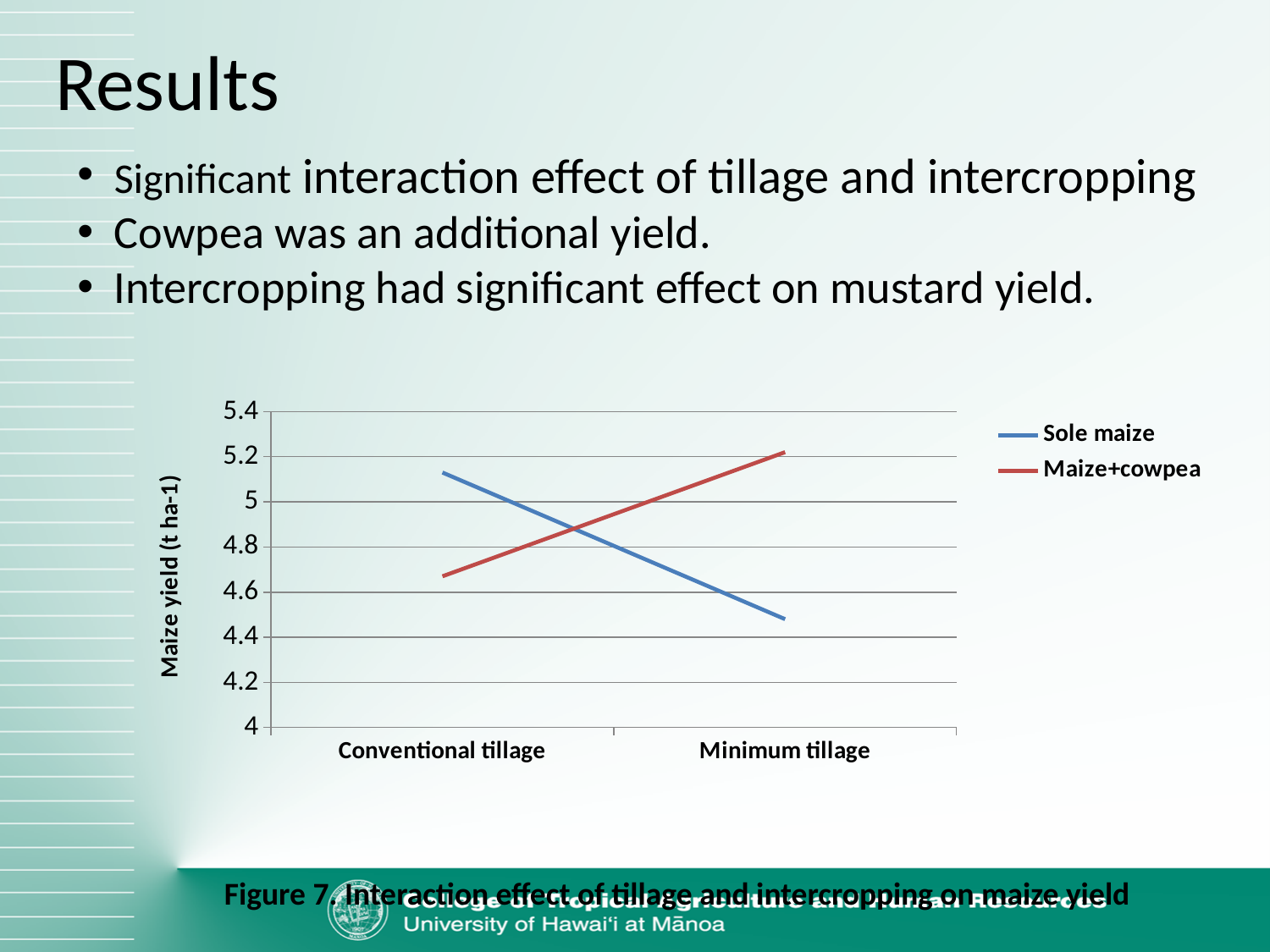
Is the value for Maize+cowpea under Minimum tillage greater or less than 5? greater Does the Sole maize line rise or fall from Conventional tillage to Minimum tillage? fall What kind of chart is shown on the slide? Line chart How many series does the legend list? 2 What is the label on the y axis of the chart? Maize yield (t ha-1) How many categories are shown on the x axis? 2 Is the value for Sole maize under Minimum tillage greater or less than 4.6? less Under Conventional tillage, which series has the higher maize yield, Sole maize or Maize+cowpea? Sole maize Does the Maize+cowpea line rise or fall from Conventional tillage to Minimum tillage? rise Is the value for Maize+cowpea under Conventional tillage greater or less than 4.8? less Under Minimum tillage, which series has the higher maize yield, Sole maize or Maize+cowpea? Maize+cowpea